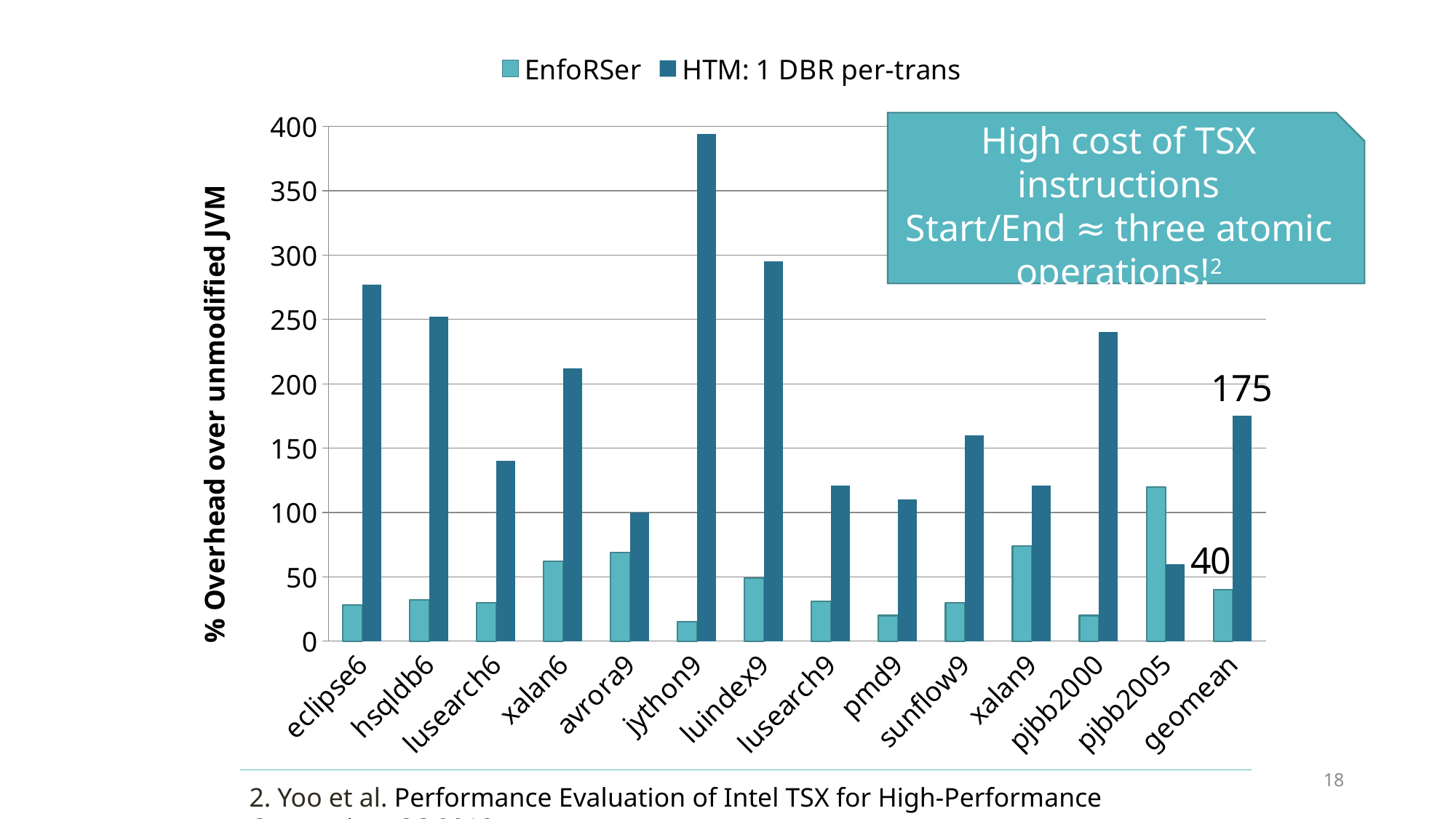
Which category has the highest EnfoRSer value? pjbb2005 Is the HTM: 1 DBR per-trans value for jython9 greater or less than 350? greater What is the value of the HTM: 1 DBR per-trans bar for geomean? 175 How many categories are shown on the x axis? 14 How many series does the legend list? 2 What is the value of the EnfoRSer bar for geomean? 40 Is the EnfoRSer value for pjbb2000 greater or less than 50? less What is the difference between the HTM: 1 DBR per-trans and EnfoRSer values for geomean? 135 Which category has the lowest EnfoRSer value? jython9 For eclipse6, which series has the larger value, EnfoRSer or HTM: 1 DBR per-trans? HTM: 1 DBR per-trans Which category has the highest HTM: 1 DBR per-trans value? jython9 What is the title of the y axis? % Overhead over unmodified JVM